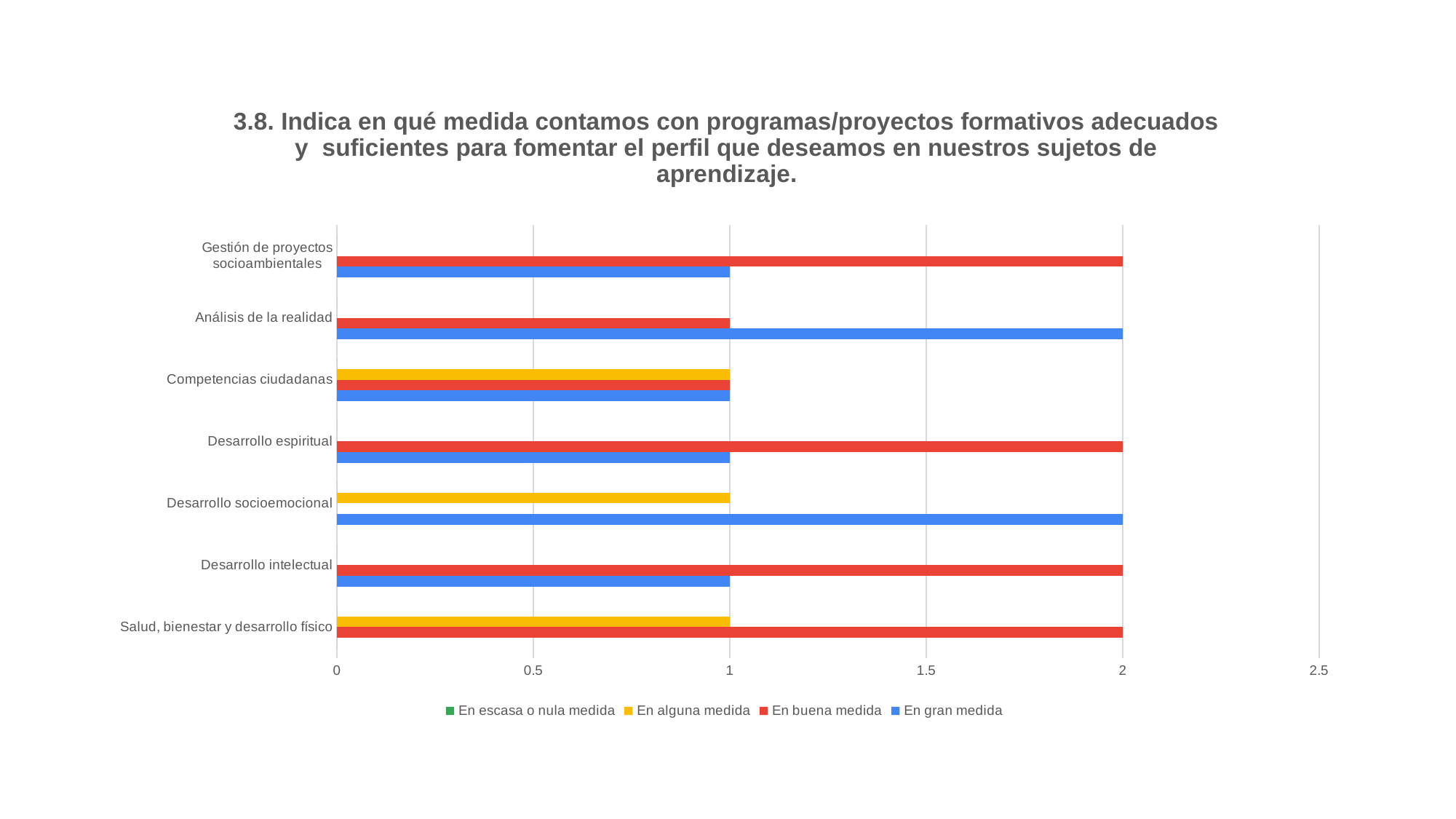
What is the value of 'En buena medida' for 'Salud, bienestar y desarrollo físico'? 2 What kind of chart is shown on the slide? Bar chart What is the value of 'En buena medida' for 'Gestión de proyectos socioambientales'? 2 What is the difference between 'En gran medida' and 'En buena medida' for 'Análisis de la realidad'? 1 Is the value of 'En gran medida' for 'Desarrollo socioemocional' greater or less than 1.5? greater What is the value of 'En gran medida' for 'Competencias ciudadanas'? 1 For 'Desarrollo espiritual', which is larger: 'En buena medida' or 'En gran medida'? En buena medida What is the value of 'En gran medida' for 'Análisis de la realidad'? 2 How many series does the legend list? 4 How many categories are listed on the vertical axis of the chart? 7 What is the value of 'En alguna medida' for 'Desarrollo socioemocional'? 1 Which series is shown in blue in the legend? En gran medida